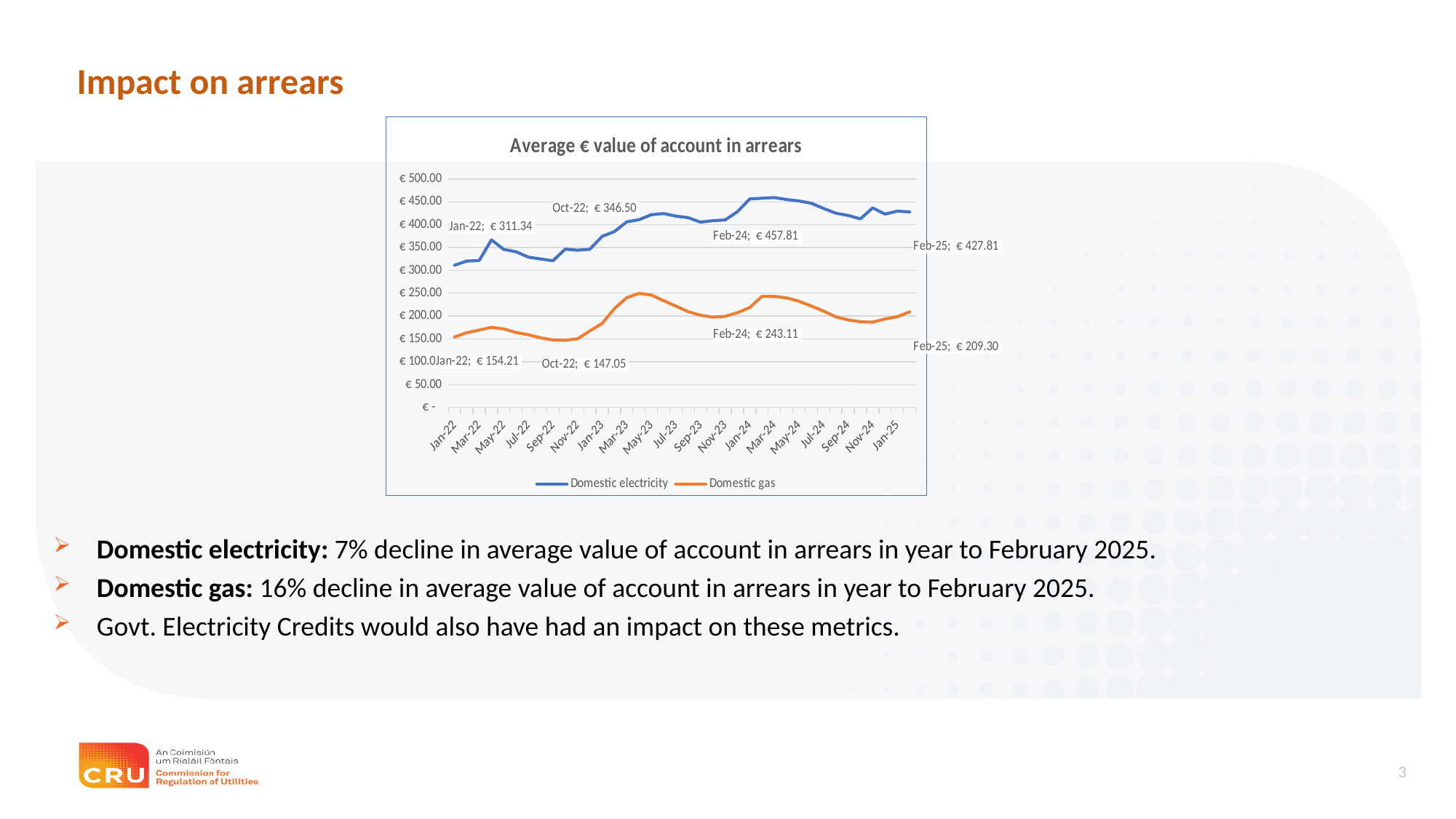
What is the value for Domestic electricity in Jan-22? € 311.34 How many series does the legend list? 2 Which series has the larger value in Feb-25, Domestic electricity or Domestic gas? Domestic electricity Is the value for Domestic gas in May-23 greater or less than € 200.00? greater What kind of chart is shown on the slide? Line chart Is the value for Domestic electricity in Sep-22 greater or less than € 350.00? less What is the difference between the Domestic gas values in Feb-24 and Feb-25? € 33.81 What is the value for Domestic gas in Feb-25? € 209.30 What is the difference between the Domestic electricity values in Feb-24 and Feb-25? € 30.00 What is the value for Domestic gas in Oct-22? € 147.05 What is the title of the chart? Average € value of account in arrears What is the value for Domestic electricity in Feb-24? € 457.81